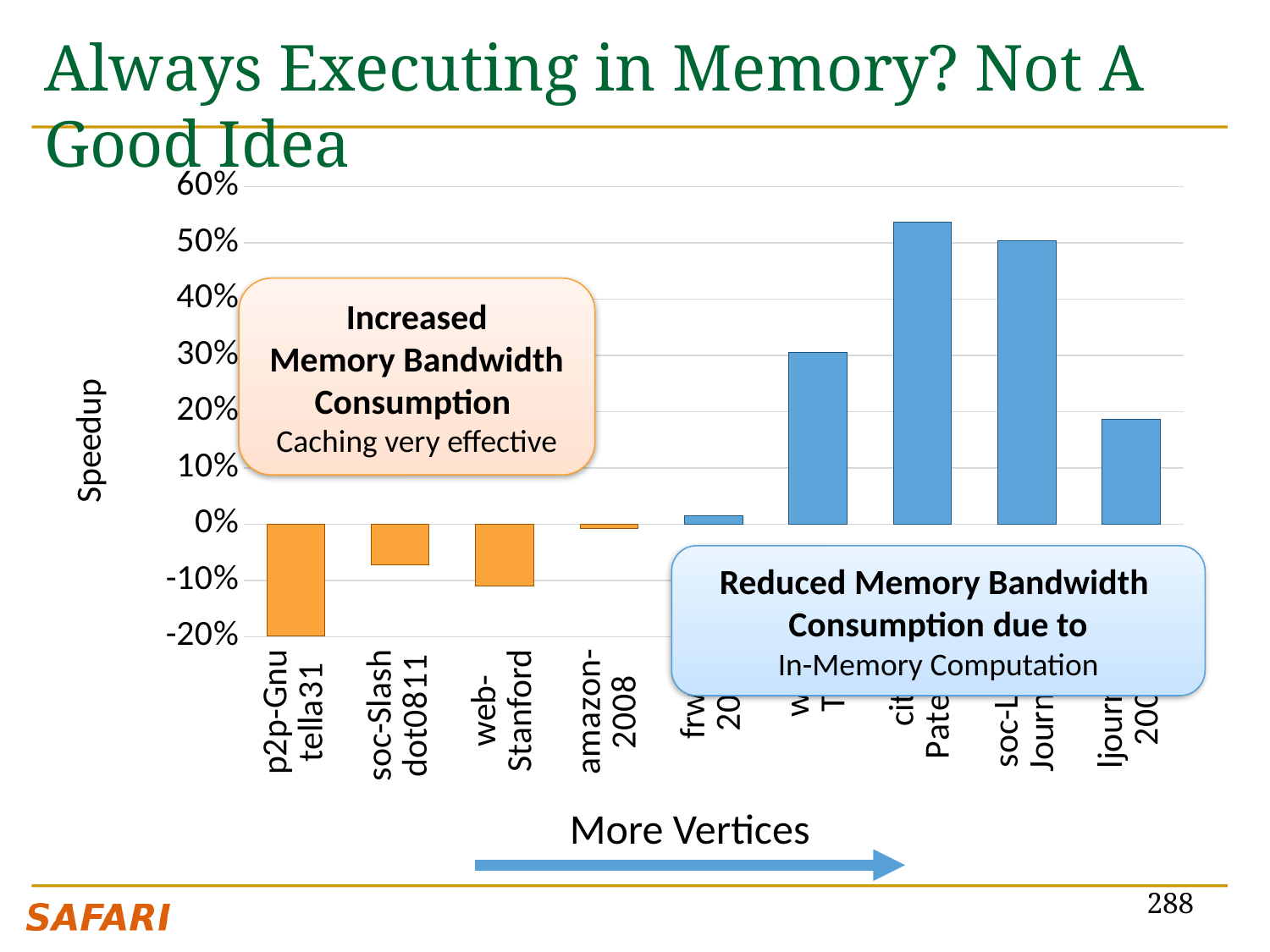
Which category has the lowest speedup? p2p-Gnutella31 Is the speedup for amazon-2008 greater or less than 0%? less Is the speedup for web-Stanford greater or less than -10%? less How many bars (categories) are plotted in the chart? 9 Do the speedup values generally rise or fall moving from left to right along the x axis? rise Is the speedup for soc-Slashdot0811 greater or less than 0%? less Which has the higher speedup, soc-Slashdot0811 or web-Stanford? soc-Slashdot0811 What kind of chart is shown on the slide? bar chart What colour are the bars with negative speedup? orange What is the label of the vertical axis? Speedup Which has the higher speedup, p2p-Gnutella31 or amazon-2008? amazon-2008